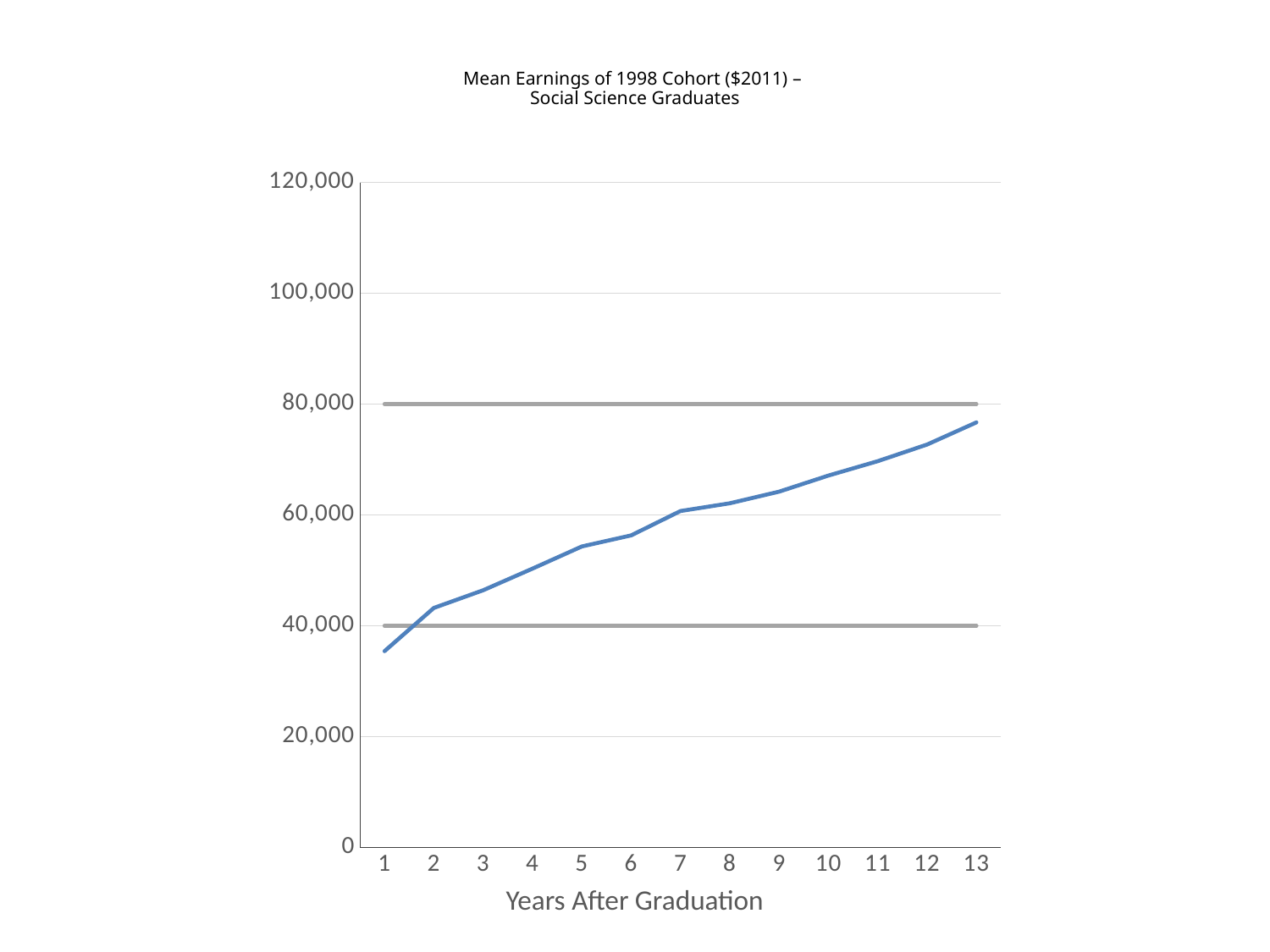
Which is larger, the value for year 2 or the value for year 10? year 10 Is the value for year 1 greater or less than 40,000? less At which year after graduation are mean earnings highest? 13 At which year after graduation are mean earnings lowest? 1 Is the value for year 13 greater or less than 80,000? less How many years after graduation are plotted along the x axis? 13 What is the label of the x axis? Years After Graduation What kind of chart is shown on the slide? line chart What is the title of the chart? Mean Earnings of 1998 Cohort ($2011) – Social Science Graduates Do mean earnings rise or fall as years after graduation increase? rise Is the value for year 4 greater or less than 60,000? less